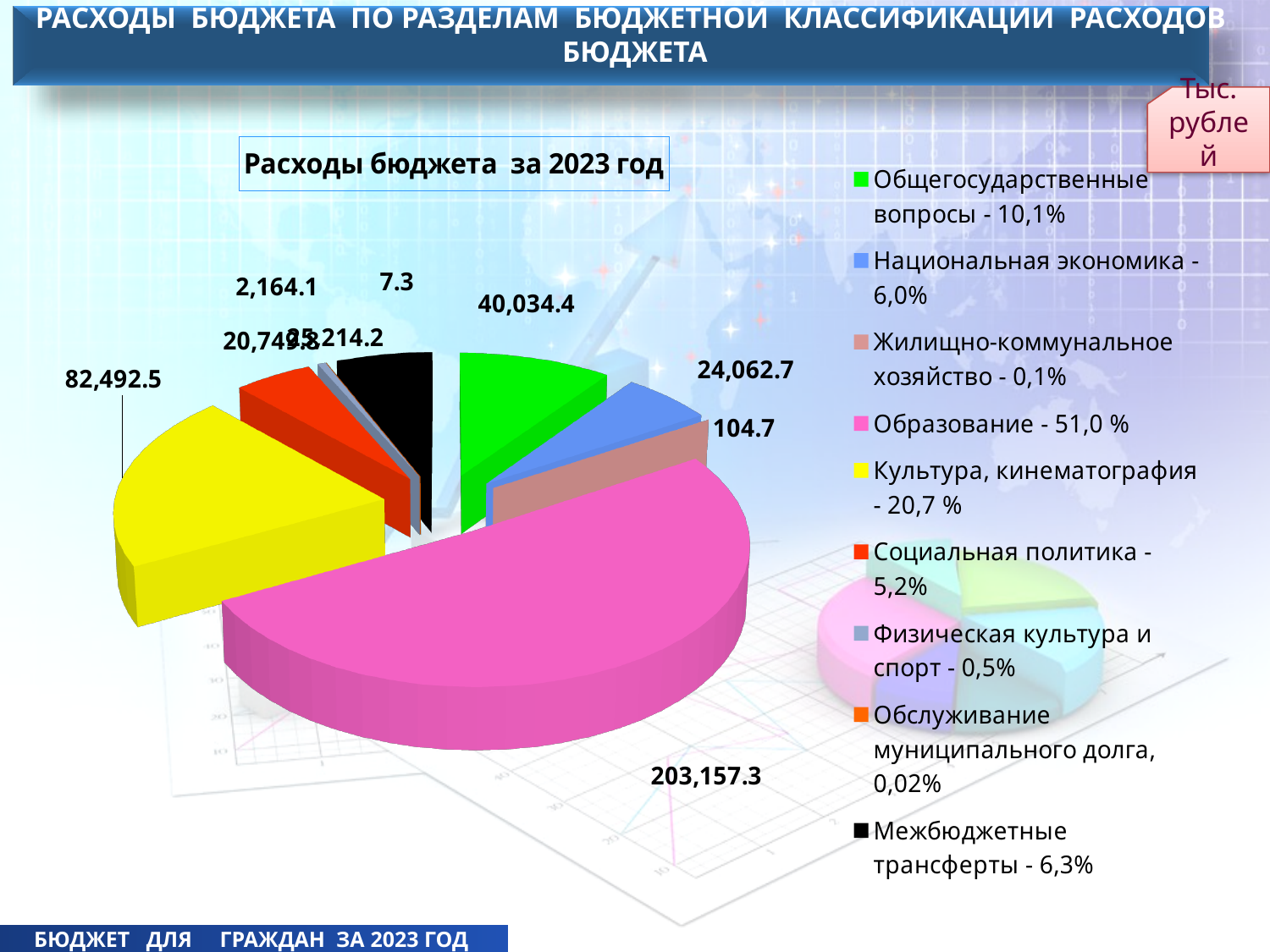
What is the title of the pie chart? Расходы бюджета за 2023 год What kind of chart is shown on the slide? Pie chart What is the value for Жилищно-коммунальное хозяйство in the pie chart? 104.7 What is the value for Культура, кинематография in the pie chart? 82,492.5 What is the value for Образование in the pie chart? 203,157.3 How many categories does the pie chart legend list? 9 Which category has the smallest value in the pie chart? Обслуживание муниципального долга What share of the pie does Образование account for, according to the legend? 51,0 % Which category has the largest slice of the pie chart? Образование What is the value for Национальная экономика in the pie chart? 24,062.7 Which is larger: the value for Общегосударственные вопросы or the value for Национальная экономика? Общегосударственные вопросы What is the value for Общегосударственные вопросы in the pie chart? 40,034.4